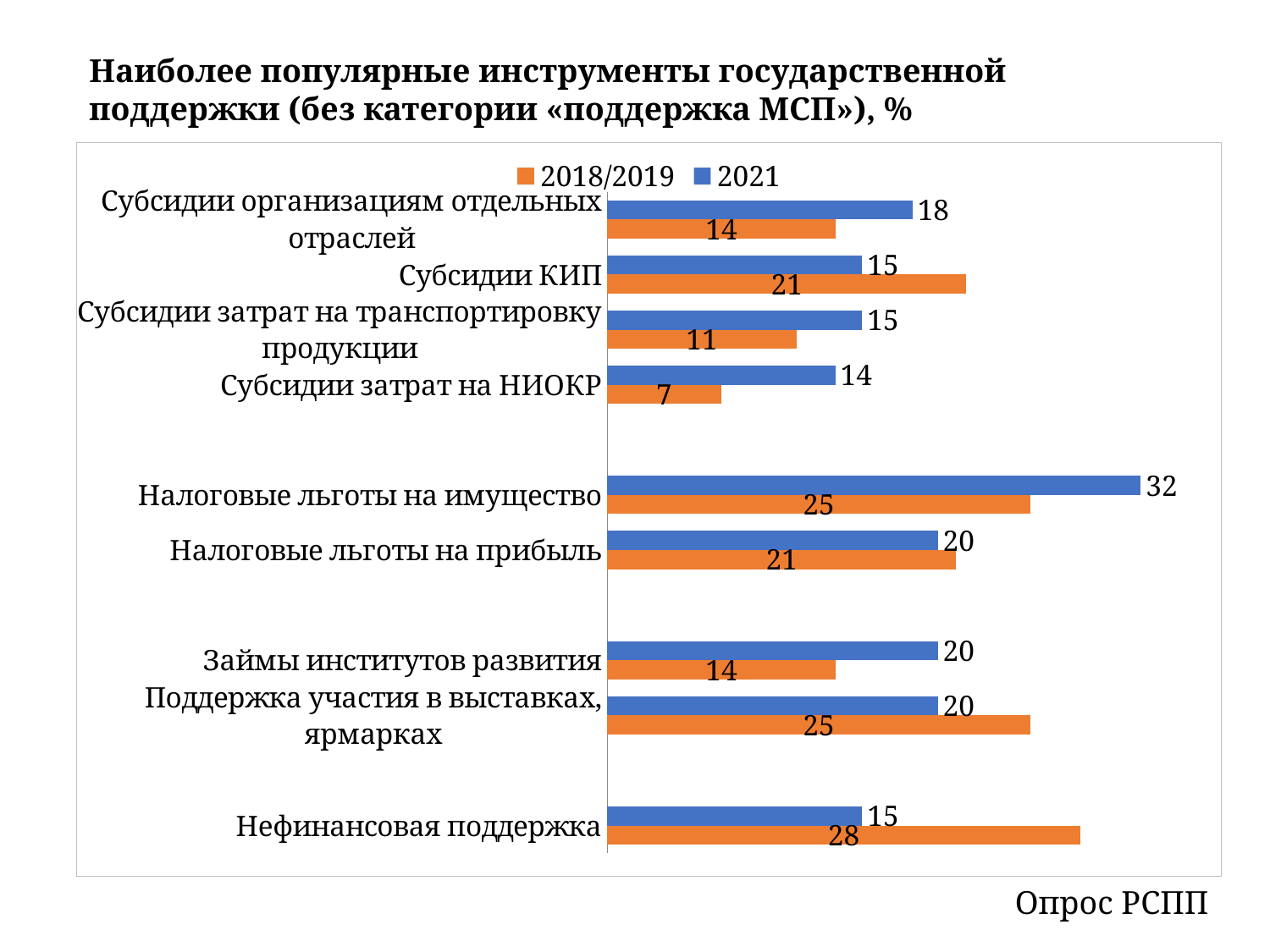
What is the 2021 value for Налоговые льготы на имущество? 32 Which category has the highest 2021 value? Налоговые льготы на имущество For Субсидии КИП, which series has the larger value, 2018/2019 or 2021? 2018/2019 How many series does the legend list? 2 What is the difference between the 2021 and 2018/2019 values for Нефинансовая поддержка? 13 How many categories are plotted in the chart? 9 What is the 2018/2019 value for Нефинансовая поддержка? 28 Which category has the lowest 2018/2019 value? Субсидии затрат на НИОКР What is the difference between the 2021 and 2018/2019 values for Налоговые льготы на имущество? 7 What type of chart is shown on the slide? bar chart What is the 2018/2019 value for Субсидии затрат на НИОКР? 7 Which colour represents the 2021 series in the chart? blue